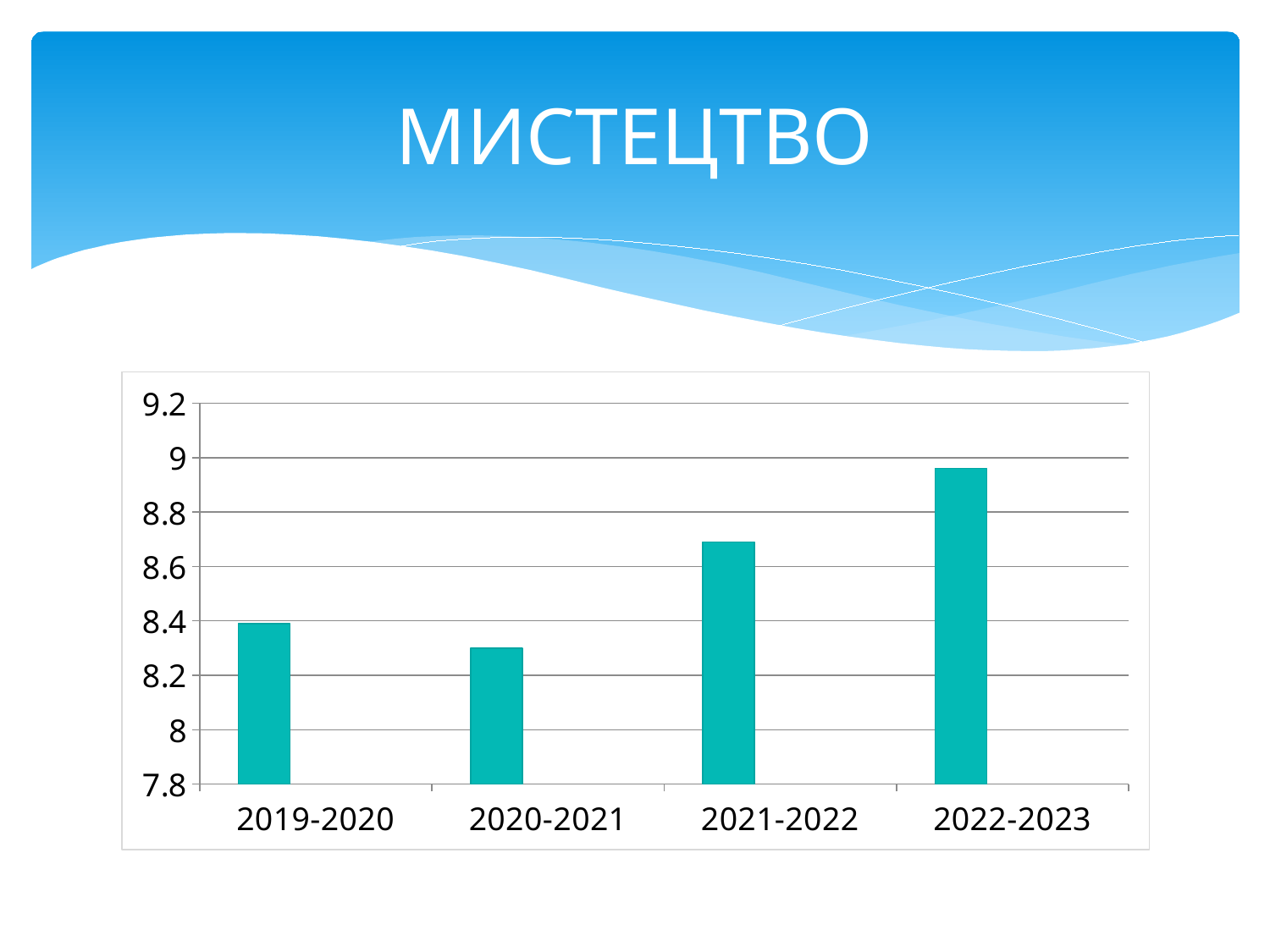
Which is larger, the value for 2019-2020 or the value for 2022-2023? 2022-2023 How many categories are shown on the x axis of the chart? 4 Which category has the lowest bar in the chart? 2020-2021 Is the value for 2022-2023 greater or less than 8.8? greater Which category has the highest bar in the chart? 2022-2023 What kind of chart is shown on the slide? bar chart Is the value for 2021-2022 greater or less than 8.6? greater Is the value for 2022-2023 greater or less than 9? less Which is larger, the value for 2021-2022 or the value for 2020-2021? 2021-2022 What is the title shown above the chart on the slide? МИСТЕЦТВО Do the values rise or fall from 2020-2021 to 2022-2023? rise